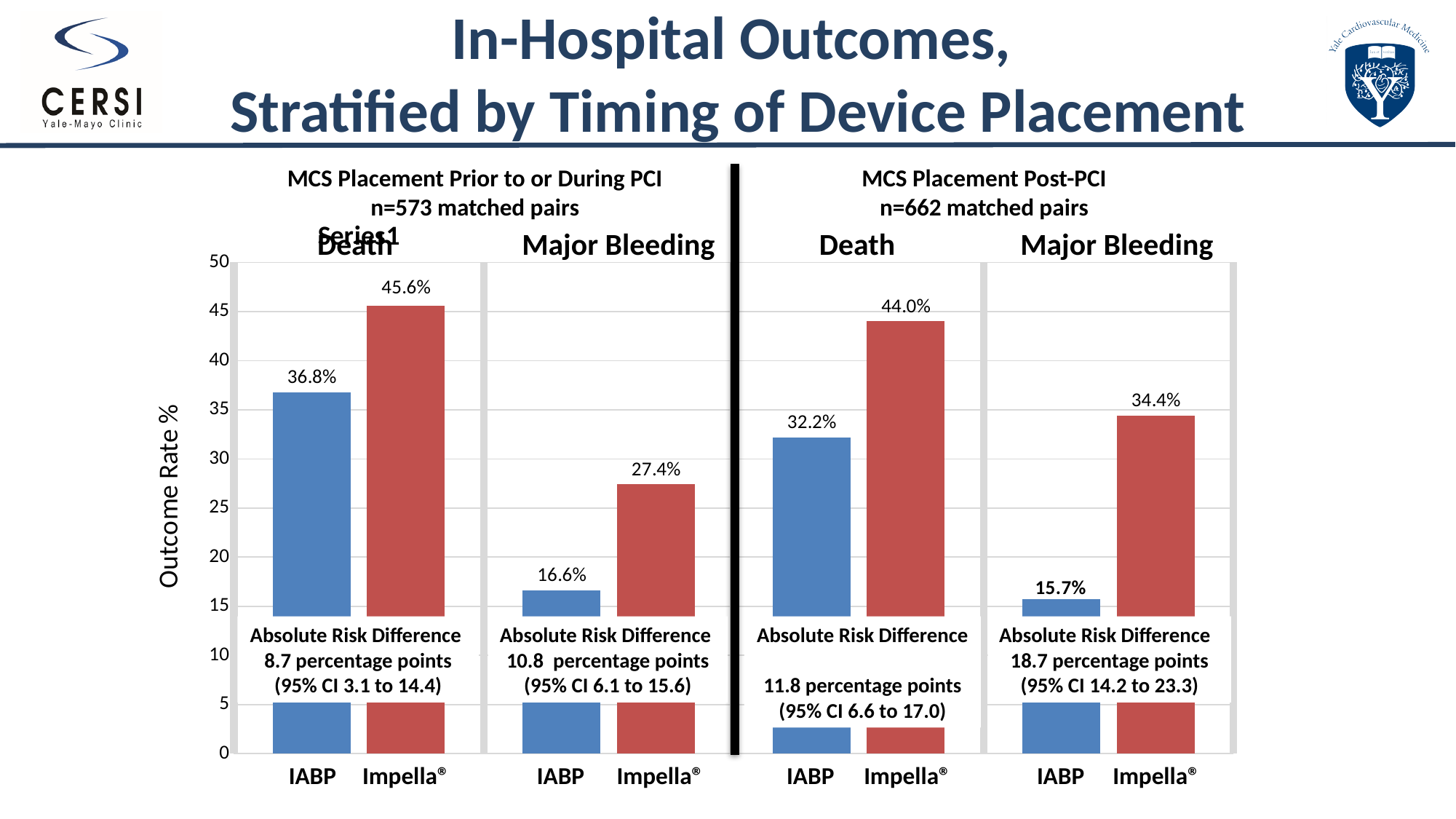
In the MCS Placement Post-PCI chart, which device has the higher death rate, IABP or Impella? Impella In the MCS Placement Prior to or During PCI chart, is the IABP major bleeding rate greater or less than 20? less In the MCS Placement Post-PCI chart, what is the major bleeding rate for IABP? 15.7% What type of chart is used on this slide? Bar chart Across all four panels on the slide, which bar shows the lowest outcome rate? IABP major bleeding rate, Post-PCI (15.7%) In the MCS Placement Post-PCI chart, what is the difference between the Impella and IABP death rates? 11.8 percentage points In the MCS Placement Prior to or During PCI chart, what is the death rate for IABP? 36.8% In the MCS Placement Prior to or During PCI chart, what is the difference between the Impella and IABP major bleeding rates? 10.8 percentage points In the MCS Placement Prior to or During PCI chart, what is the death rate for Impella? 45.6% Across all four panels on the slide, which bar shows the highest outcome rate? Impella death rate, Prior to or During PCI (45.6%) What is the label of the y axis on the slide? Outcome Rate % In the MCS Placement Post-PCI chart, what is the major bleeding rate for Impella? 34.4%